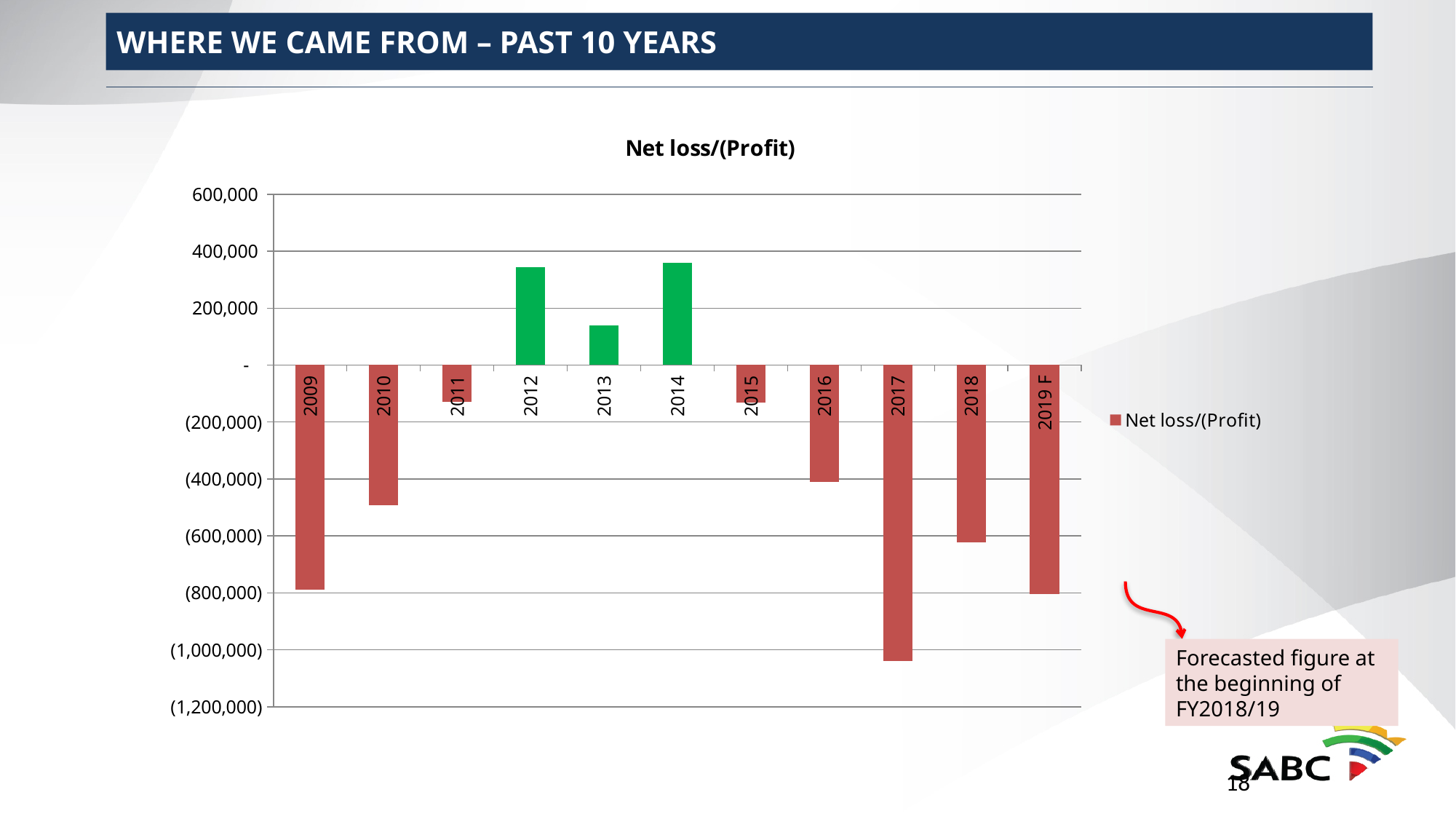
Is the value for 2010 greater or less than (400,000)? less How many years (categories) are plotted on the x axis? 11 Which has the lower value, 2010 or 2011? 2010 What kind of chart is shown on the slide? bar chart Is the value for 2017 greater or less than (1,000,000)? less Which year has the lowest value (largest net loss) on the chart? 2017 How many bars are coloured green (positive values) on the chart? 3 What is the title of the chart? Net loss/(Profit) How many series does the legend list? 1 Which has the higher value, 2012 or 2013? 2012 Is the value for 2012 greater or less than 200,000? greater